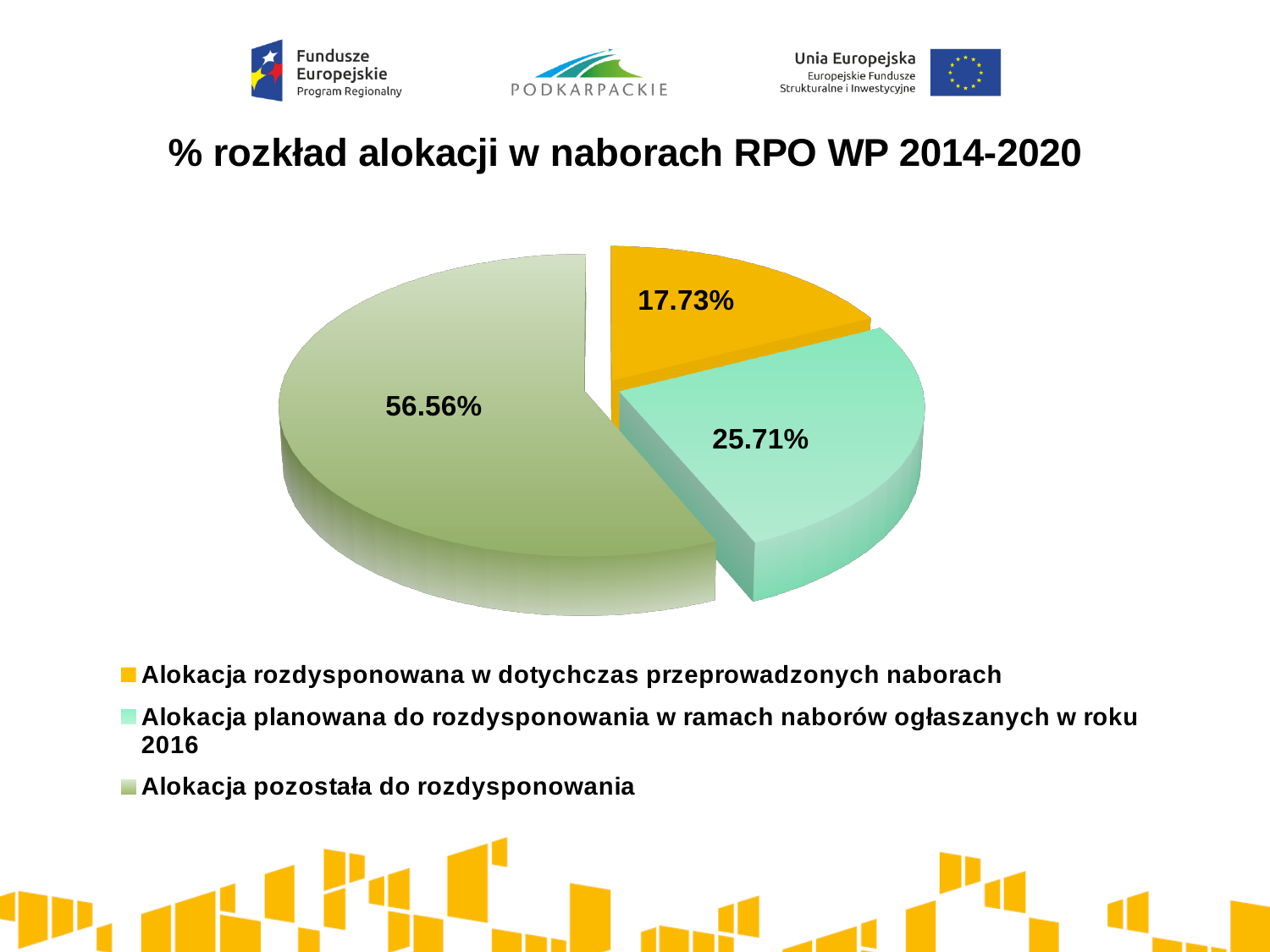
What type of chart is shown on the slide? Pie chart What colour is the slice for 'Alokacja rozdysponowana w dotychczas przeprowadzonych naborach'? Orange What share of the pie is labelled for 'Alokacja planowana do rozdysponowania w ramach naborów ogłaszanych w roku 2016'? 25.71% Which category has the largest slice of the pie? Alokacja pozostała do rozdysponowania Which category has the smallest slice of the pie? Alokacja rozdysponowana w dotychczas przeprowadzonych naborach How many slices does the pie chart have? 3 What share of the pie is labelled for 'Alokacja rozdysponowana w dotychczas przeprowadzonych naborach'? 17.73% What is the difference in percentage points between 'Alokacja planowana do rozdysponowania w ramach naborów ogłaszanych w roku 2016' and 'Alokacja rozdysponowana w dotychczas przeprowadzonych naborach'? 7.98 Which is larger: the slice for 'Alokacja rozdysponowana w dotychczas przeprowadzonych naborach' or the slice for 'Alokacja planowana do rozdysponowania w ramach naborów ogłaszanych w roku 2016'? Alokacja planowana do rozdysponowania w ramach naborów ogłaszanych w roku 2016 What share of the pie is labelled for 'Alokacja pozostała do rozdysponowania'? 56.56% What is the difference in percentage points between 'Alokacja pozostała do rozdysponowania' and 'Alokacja planowana do rozdysponowania w ramach naborów ogłaszanych w roku 2016'? 30.85 What is the title of the chart? % rozkład alokacji w naborach RPO WP 2014-2020